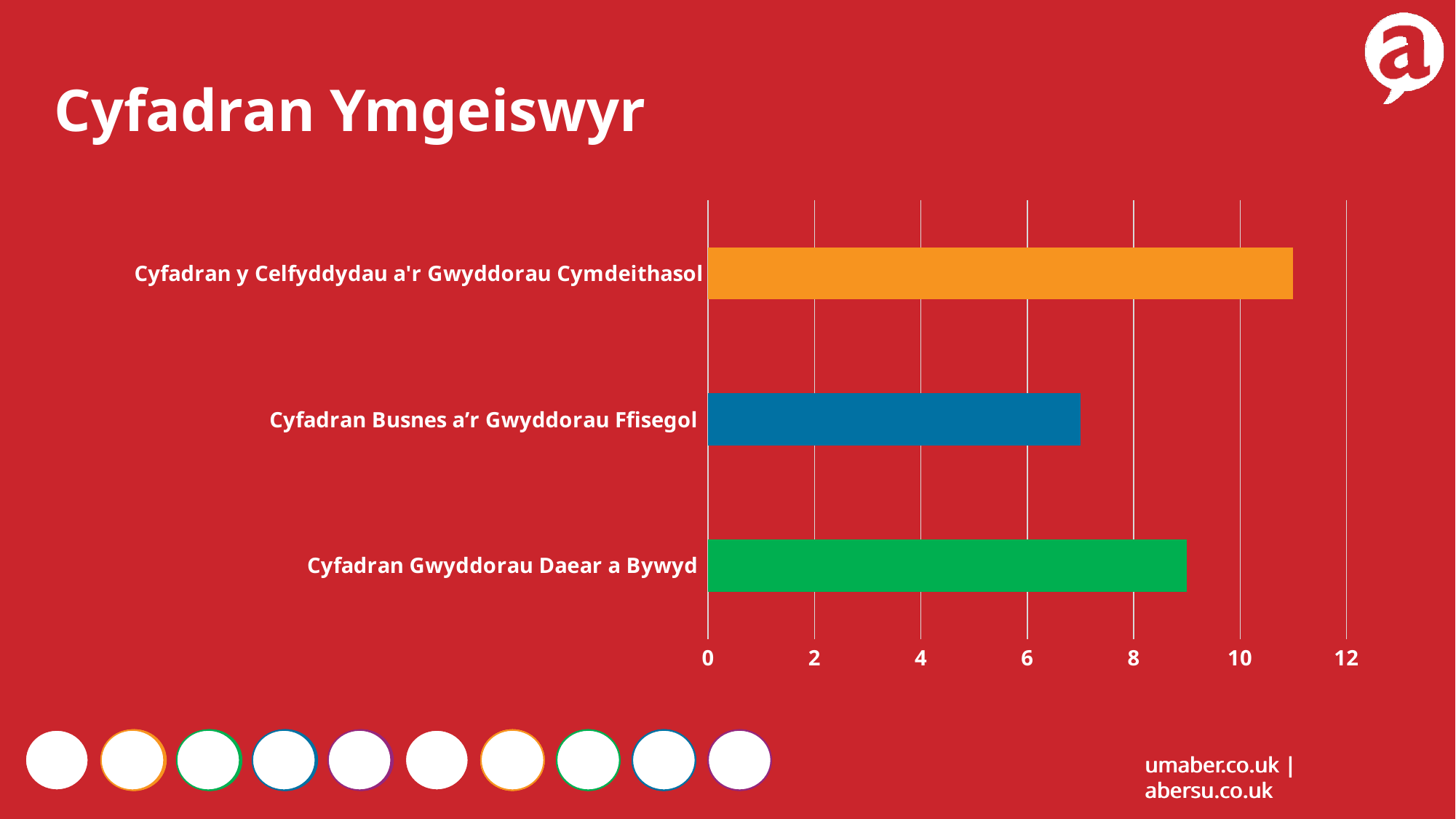
What kind of chart is shown on the slide? bar chart What is the title of the chart on the slide? Cyfadran Ymgeiswyr Is the value for Cyfadran Busnes a'r Gwyddorau Ffisegol greater or less than 8? less How many categories are plotted in the chart? 3 Is the value for Cyfadran Gwyddorau Daear a Bywyd greater or less than 10? less Which category has the highest value? Cyfadran y Celfyddydau a'r Gwyddorau Cymdeithasol Which is larger, the value for Cyfadran y Celfyddydau a'r Gwyddorau Cymdeithasol or the value for Cyfadran Gwyddorau Daear a Bywyd? Cyfadran y Celfyddydau a'r Gwyddorau Cymdeithasol Which is larger, the value for Cyfadran Gwyddorau Daear a Bywyd or the value for Cyfadran Busnes a'r Gwyddorau Ffisegol? Cyfadran Gwyddorau Daear a Bywyd Is the value for Cyfadran Busnes a'r Gwyddorau Ffisegol greater or less than 6? greater What colour is the bar for Cyfadran Gwyddorau Daear a Bywyd? green Which category has the lowest value? Cyfadran Busnes a'r Gwyddorau Ffisegol